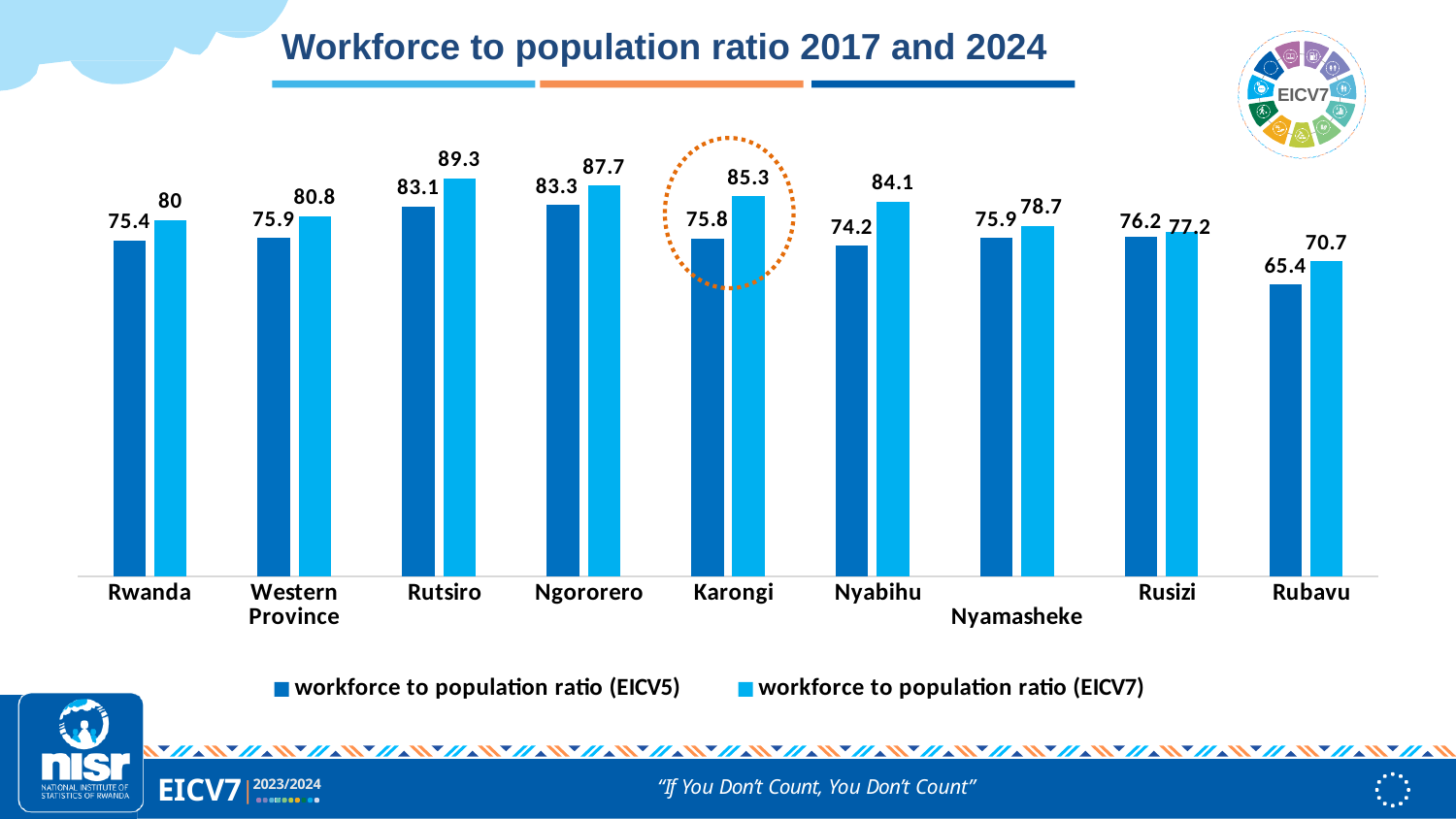
What is the title of the chart? Workforce to population ratio 2017 and 2024 What is the difference between the EICV7 and EICV5 workforce to population ratios for Rutsiro? 6.2 What is the difference between the EICV7 and EICV5 workforce to population ratios for Nyabihu? 9.9 What is the workforce to population ratio (EICV5) for Rubavu? 65.4 What is the workforce to population ratio (EICV7) for Rwanda? 80 Which is larger, the EICV5 workforce to population ratio for Ngororero or for Rutsiro? Ngororero Which category has the lowest workforce to population ratio (EICV5)? Rubavu How many series does the legend list? 2 How many categories are shown on the x axis of the chart? 9 What is the workforce to population ratio (EICV7) for Karongi? 85.3 Which category has the highest workforce to population ratio (EICV7)? Rutsiro What kind of chart is shown on the slide? Bar chart